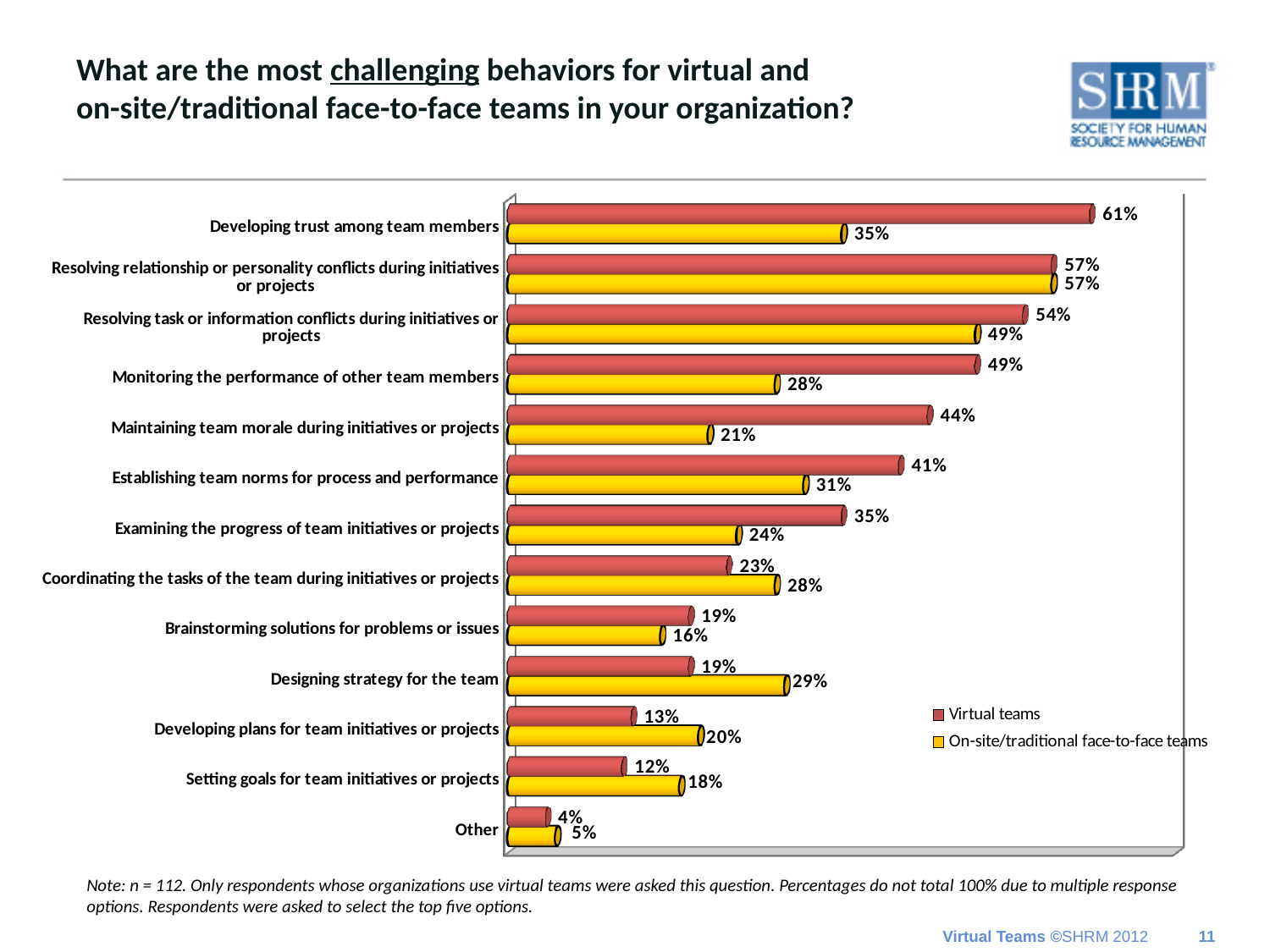
What is the difference between the virtual teams and on-site/traditional face-to-face teams values for 'Developing trust among team members'? 26% How many series does the legend list? 2 For 'Coordinating the tasks of the team during initiatives or projects', which series has the larger value? On-site/traditional face-to-face teams What is the value for on-site/traditional face-to-face teams for 'Monitoring the performance of other team members'? 28% For 'Maintaining team morale during initiatives or projects', which series has the larger value? Virtual teams Which category has the lowest value for on-site/traditional face-to-face teams? Other How many categories are shown on the chart? 13 Which colour represents virtual teams in the chart? Red What type of chart is shown on the slide? Bar chart What is the value for virtual teams for 'Designing strategy for the team'? 19% Which category has the highest value for virtual teams? Developing trust among team members What percentage of respondents selected 'Developing trust among team members' as challenging for virtual teams? 61%